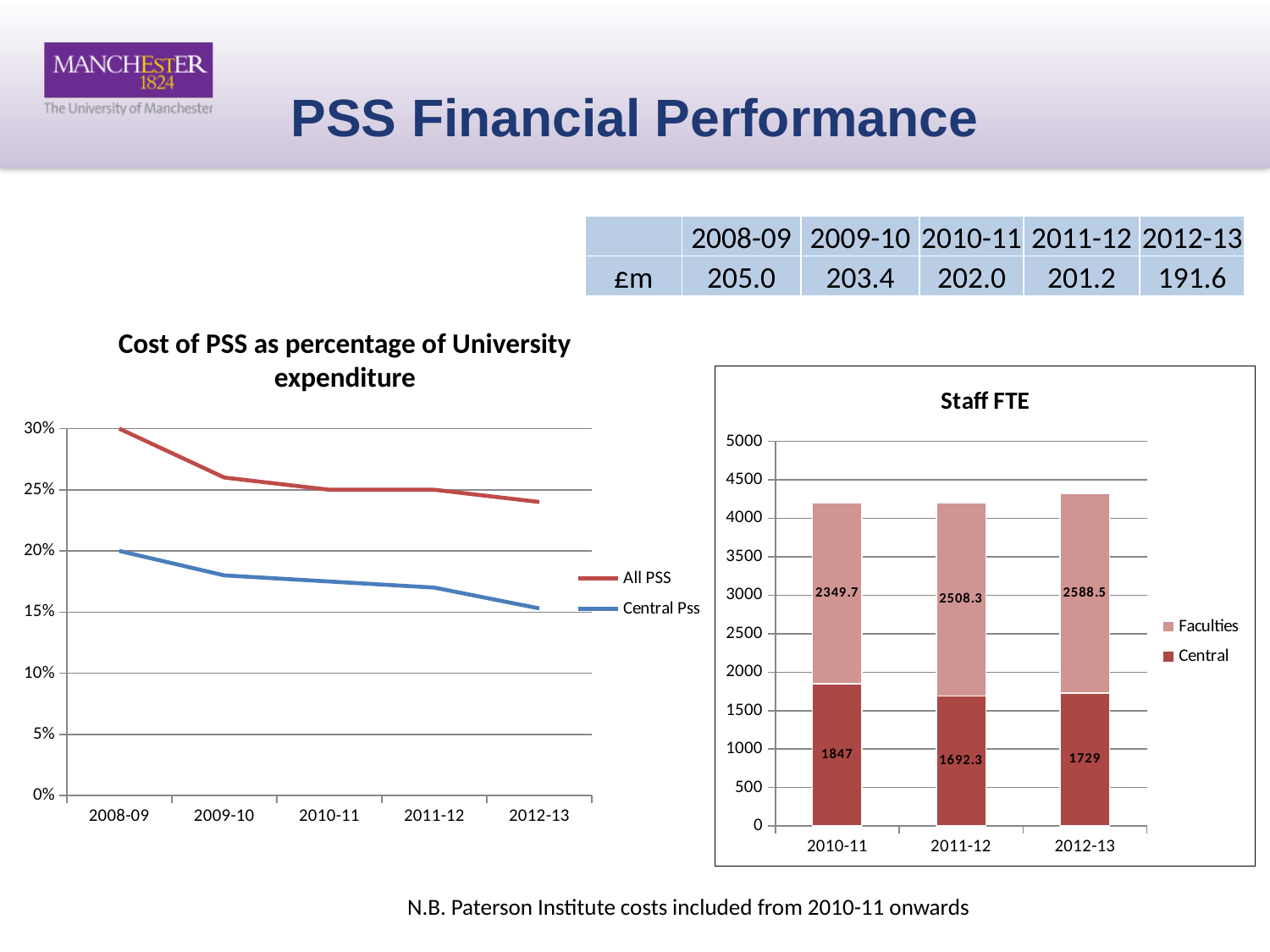
In the Staff FTE chart, what is the Faculties value for 2012-13? 2588.5 What kind of chart is the Staff FTE chart? Stacked bar chart In the Cost of PSS as percentage of University expenditure chart, is the All PSS value for 2012-13 greater or less than 25%? less In the Staff FTE chart, what is the Faculties value for 2011-12? 2508.3 In the Staff FTE chart, what is the Central value for 2010-11? 1847 In the Staff FTE chart, which year has the lowest Central value? 2011-12 In the Staff FTE chart, how many series does the legend list? 2 In the Staff FTE chart, what is the total of the stacked bar for 2012-13? 4317.5 In the Staff FTE chart, which year has the highest Faculties value? 2012-13 In the Cost of PSS as percentage of University expenditure chart, how many years are shown on the x axis? 5 In the Cost of PSS as percentage of University expenditure chart, do the Central Pss values rise or fall from 2008-09 to 2012-13? fall In the Staff FTE chart, what is the difference between the Faculties values for 2012-13 and 2010-11? 238.8